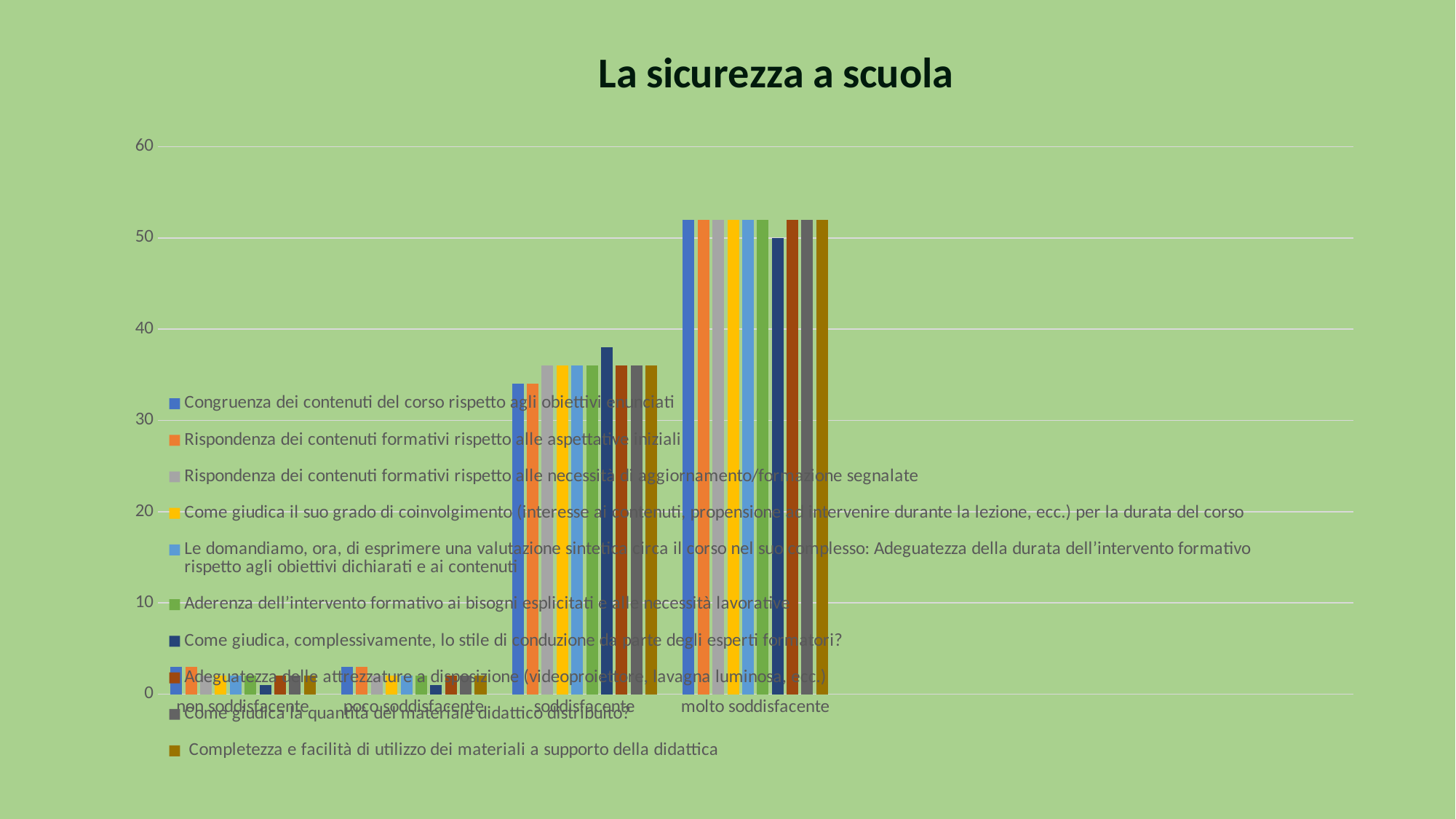
Which category has the highest value for 'Congruenza dei contenuti del corso rispetto agli obiettivi enunciati'? molto soddisfacente What kind of chart is shown on the slide? bar chart Is the value for 'Congruenza dei contenuti del corso rispetto agli obiettivi enunciati' at 'molto soddisfacente' greater or less than 50? greater How many categories are shown on the x axis? 4 Is the value for 'Congruenza dei contenuti del corso rispetto agli obiettivi enunciati' at 'soddisfacente' greater or less than 30? greater How many series does the legend list? 10 Is the value for 'Congruenza dei contenuti del corso rispetto agli obiettivi enunciati' at 'soddisfacente' greater or less than 40? less For 'Rispondenza dei contenuti formativi rispetto alle aspettative iniziali', which is larger: the value at 'soddisfacente' or at 'molto soddisfacente'? molto soddisfacente What is the title of the chart? La sicurezza a scuola Do the values for 'Congruenza dei contenuti del corso rispetto agli obiettivi enunciati' generally rise or fall from 'non soddisfacente' to 'molto soddisfacente'? rise Which series is listed last in the legend? Completezza e facilità di utilizzo dei materiali a supporto della didattica